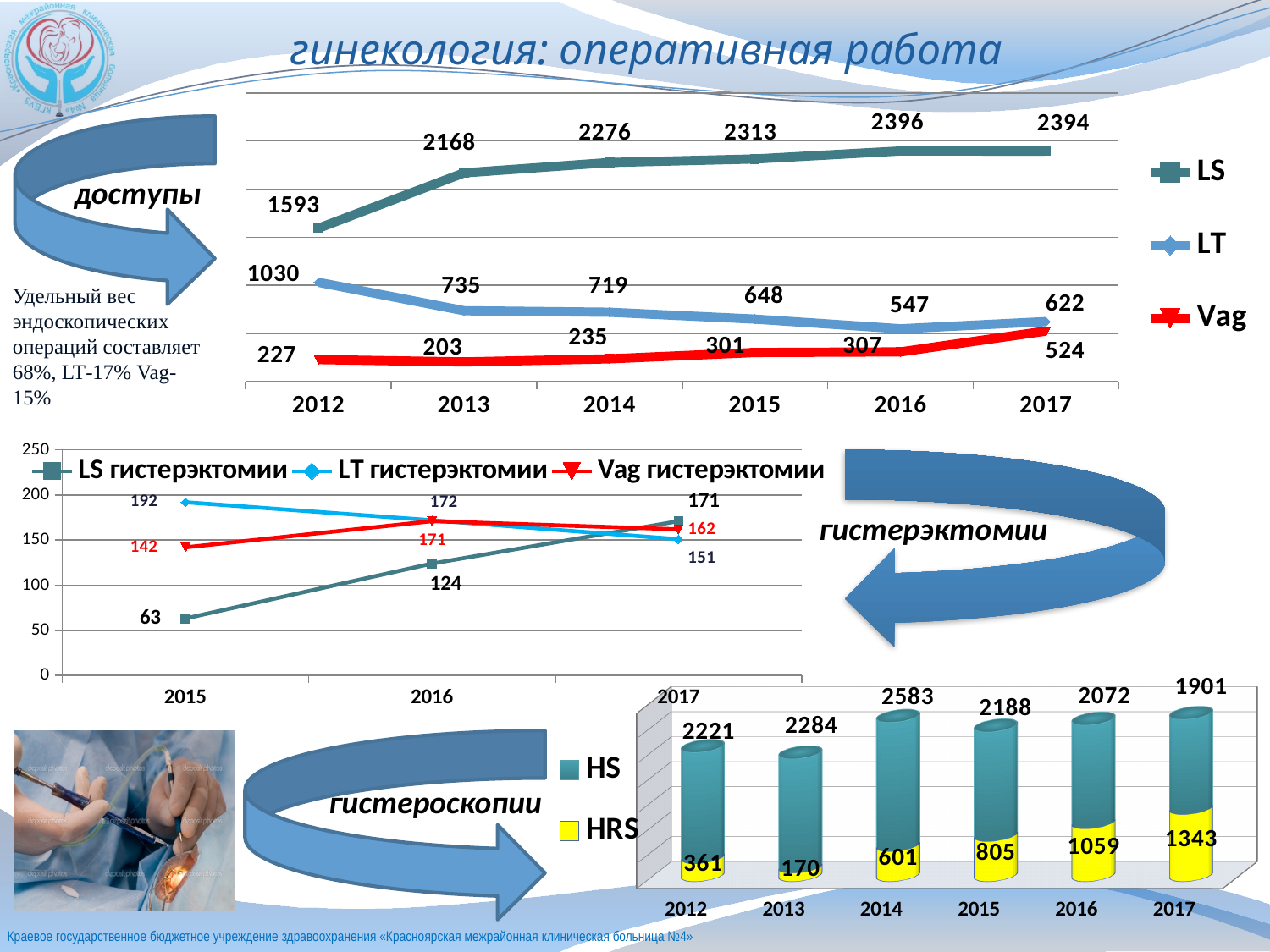
In the middle-left line chart (гистерэктомии), how many years are shown on the x axis? 3 In the bottom-right bar chart (гистероскопии), what is the HRS value for 2016? 1059 In the top line chart, what is the LT value for 2012? 1030 In the top line chart, which year has the highest Vag value? 2017 What type of chart is the bottom-right chart (гистероскопии)? bar chart In the bottom-right bar chart (гистероскопии), which year has the highest HS value? 2014 In the top line chart, what is the difference between the LS values for 2013 and 2012? 575 How many series does the legend of the top line chart list? 3 In the top line chart, what is the LS value for 2014? 2276 In the top line chart, does the LT series rise or fall from 2012 to 2016? fall In the middle-left line chart (гистерэктомии), what is the value of LS гистерэктомии for 2015? 63 In the middle-left line chart (гистерэктомии), which series has the lowest value in 2017? LT гистерэктомии